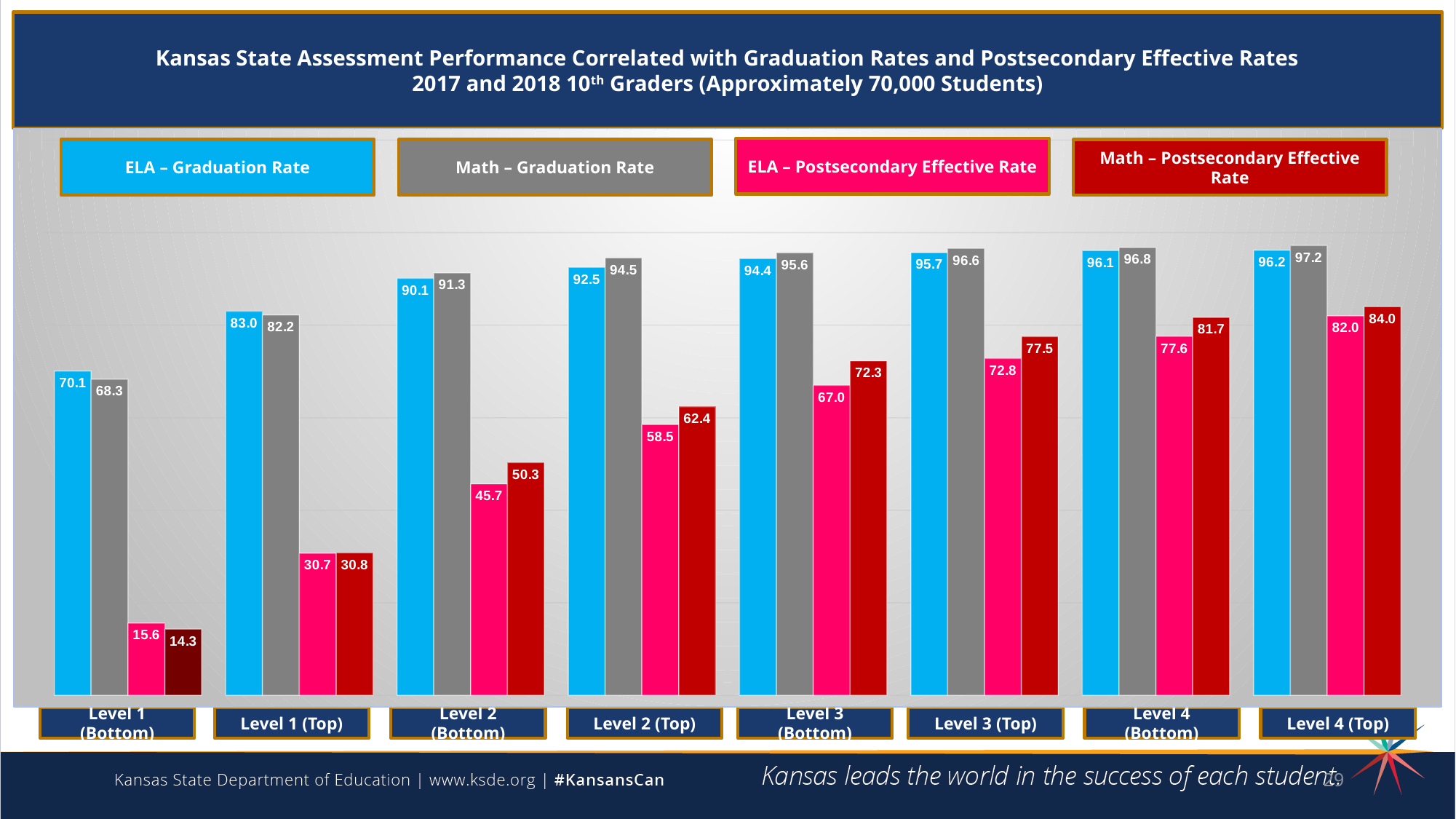
Does the ELA – Postsecondary Effective Rate rise or fall from Level 1 (Bottom) to Level 4 (Top)? Rise What is the Math – Postsecondary Effective Rate for Level 4 (Top)? 84.0 Which is larger for Level 1 (Top): the ELA – Graduation Rate or the Math – Graduation Rate? ELA – Graduation Rate What is the difference between the Math – Graduation Rate and the ELA – Graduation Rate for Level 2 (Top)? 2.0 How many series does the legend list? 4 Which category has the highest Math – Graduation Rate? Level 4 (Top) What is the ELA – Postsecondary Effective Rate for Level 2 (Bottom)? 45.7 Which category has the lowest Math – Postsecondary Effective Rate? Level 1 (Bottom) What is the ELA – Graduation Rate for Level 1 (Bottom)? 70.1 How many categories are shown on the x axis? 8 What kind of chart is shown on the slide? Bar chart What is the Math – Graduation Rate for Level 3 (Top)? 96.6